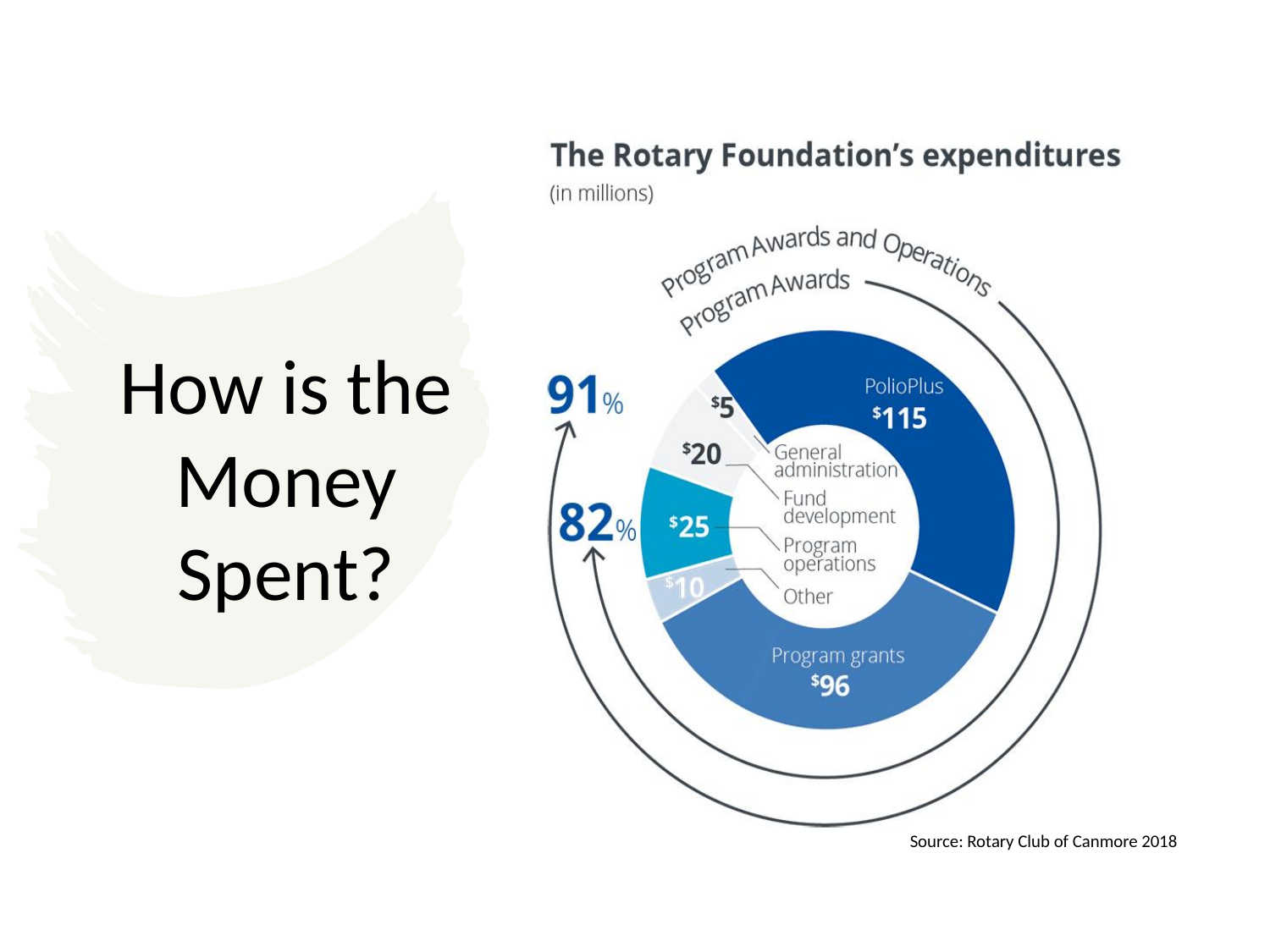
Which category has the largest expenditure? PolioPlus Which is larger, Program operations or Fund development? Program operations Which category has the smallest expenditure? General administration What is the value for Program operations? $25 What is the value for PolioPlus? $115 What percentage of expenditures does the chart attribute to Program Awards and Operations? 91% What is the difference between PolioPlus and Program grants? $19 How many expenditure categories are shown in the chart? 6 What is the value for Program grants? $96 What kind of chart is shown on the slide? Donut chart What is the value for Fund development? $20 What is the value for General administration? $5